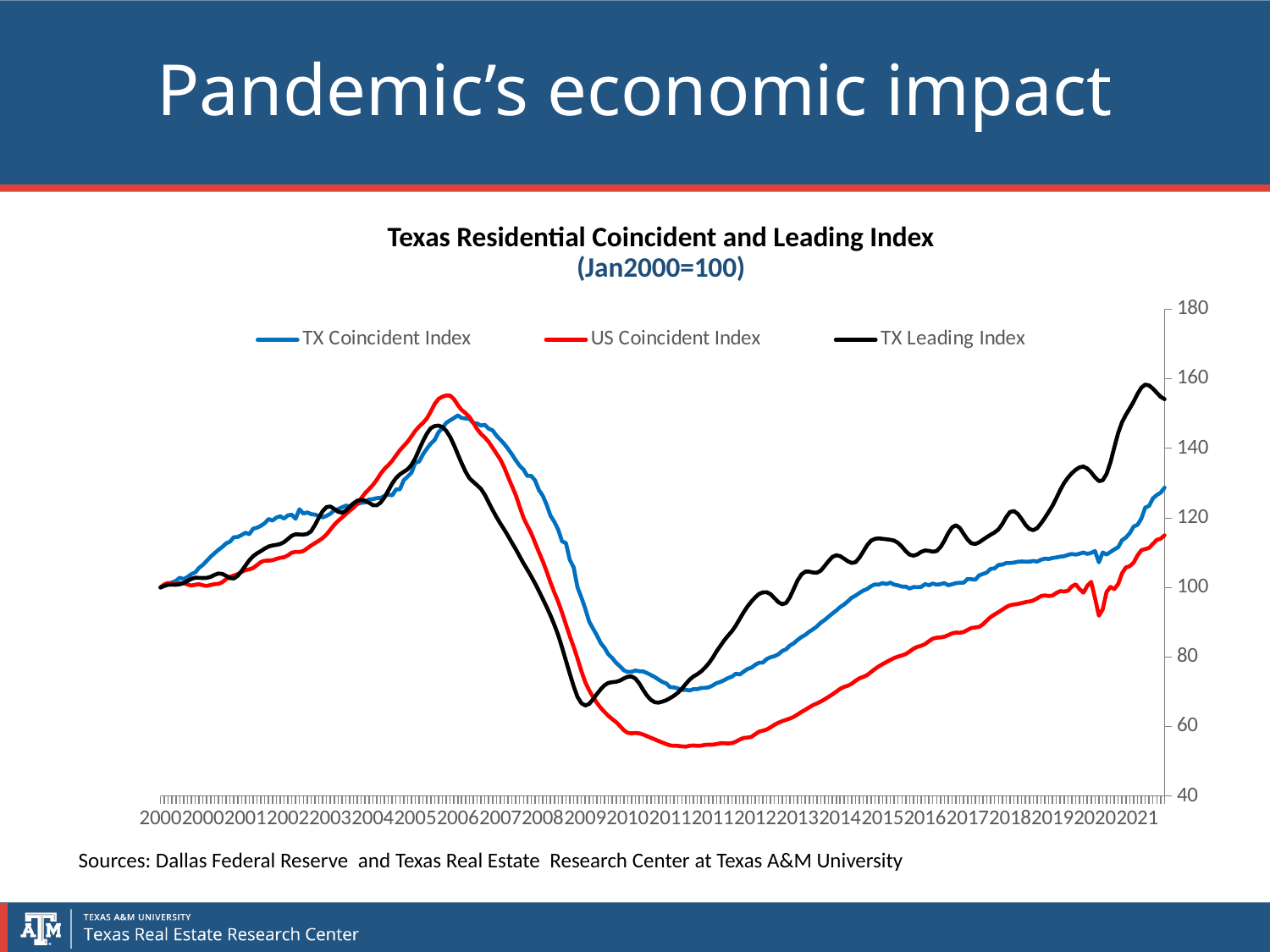
What is the title of the chart? Texas Residential Coincident and Leading Index (Jan2000=100) Does the US Coincident Index generally rise or fall between 2011 and 2021? rise Is the value of the TX Coincident Index at the end of the series (2021) greater or less than 120? greater Is the peak value of the TX Leading Index near the end of the series (around 2020-2021) greater or less than 140? greater Which series is drawn in red? US Coincident Index What kind of chart is shown on the slide? line chart Is the lowest value of the US Coincident Index (around 2011) greater or less than 60? less Which series reaches the lowest value anywhere on the chart? US Coincident Index At the end of the series (2021), which is higher: the TX Leading Index or the US Coincident Index? TX Leading Index How many series does the legend list? 3 Around 2011, which is lower: the US Coincident Index or the TX Coincident Index? US Coincident Index